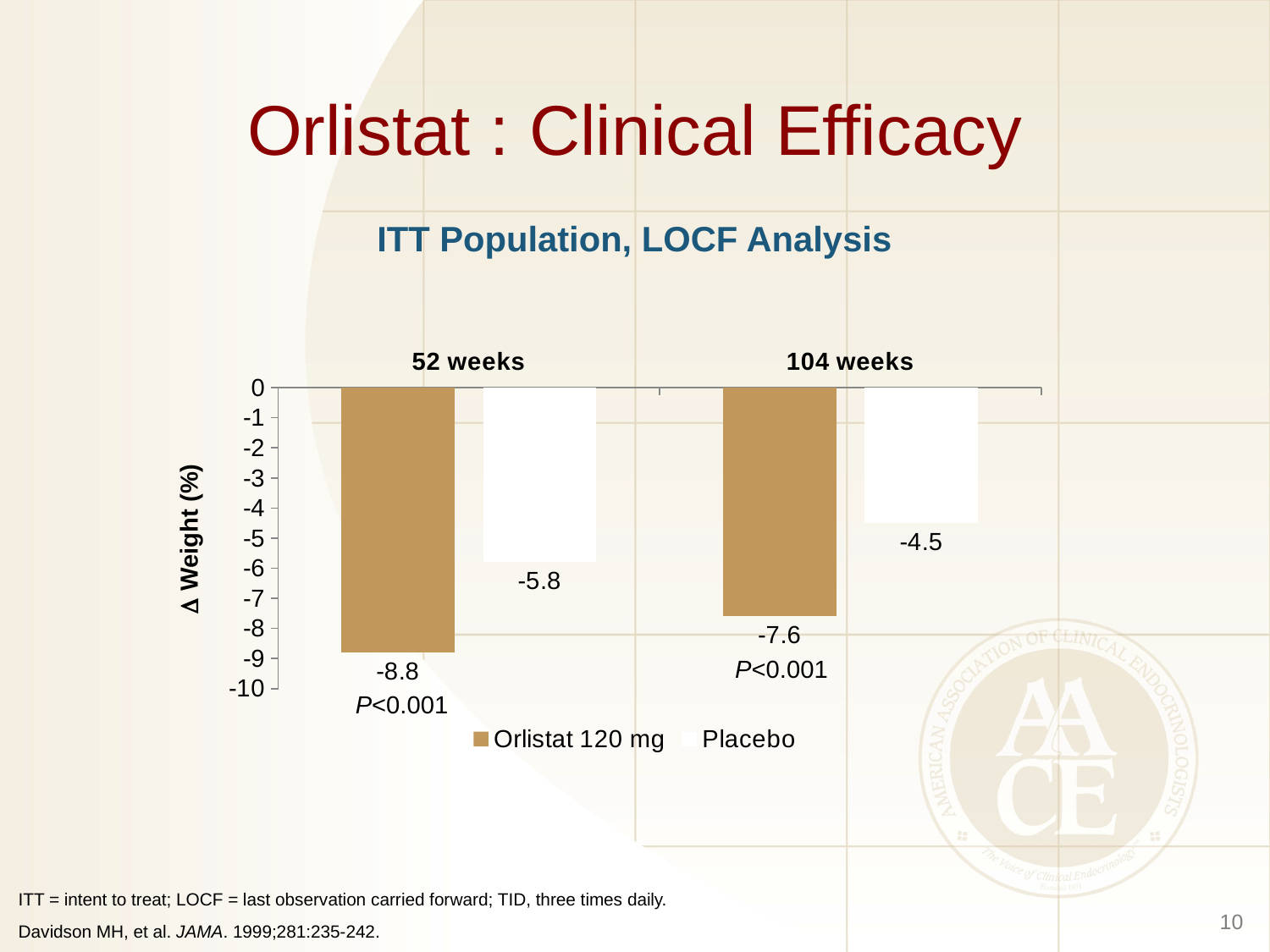
What is the change in weight (%) for Placebo at 52 weeks? -5.8 What kind of chart is shown on the slide? Bar chart Which bar shows the largest weight loss (most negative value)? Orlistat 120 mg at 52 weeks What is the difference between the Orlistat 120 mg and Placebo values at 104 weeks? 3.1 What is the change in weight (%) for Placebo at 104 weeks? -4.5 How many series does the legend list? 2 What is the change in weight (%) for Orlistat 120 mg at 104 weeks? -7.6 Which shows a greater weight loss at 104 weeks, Orlistat 120 mg or Placebo? Orlistat 120 mg Which bar shows the smallest weight loss (least negative value)? Placebo at 104 weeks What is the change in weight (%) for Orlistat 120 mg at 52 weeks? -8.8 What is the difference between the Orlistat 120 mg and Placebo values at 52 weeks? 3.0 What is the label of the vertical axis? Δ Weight (%)